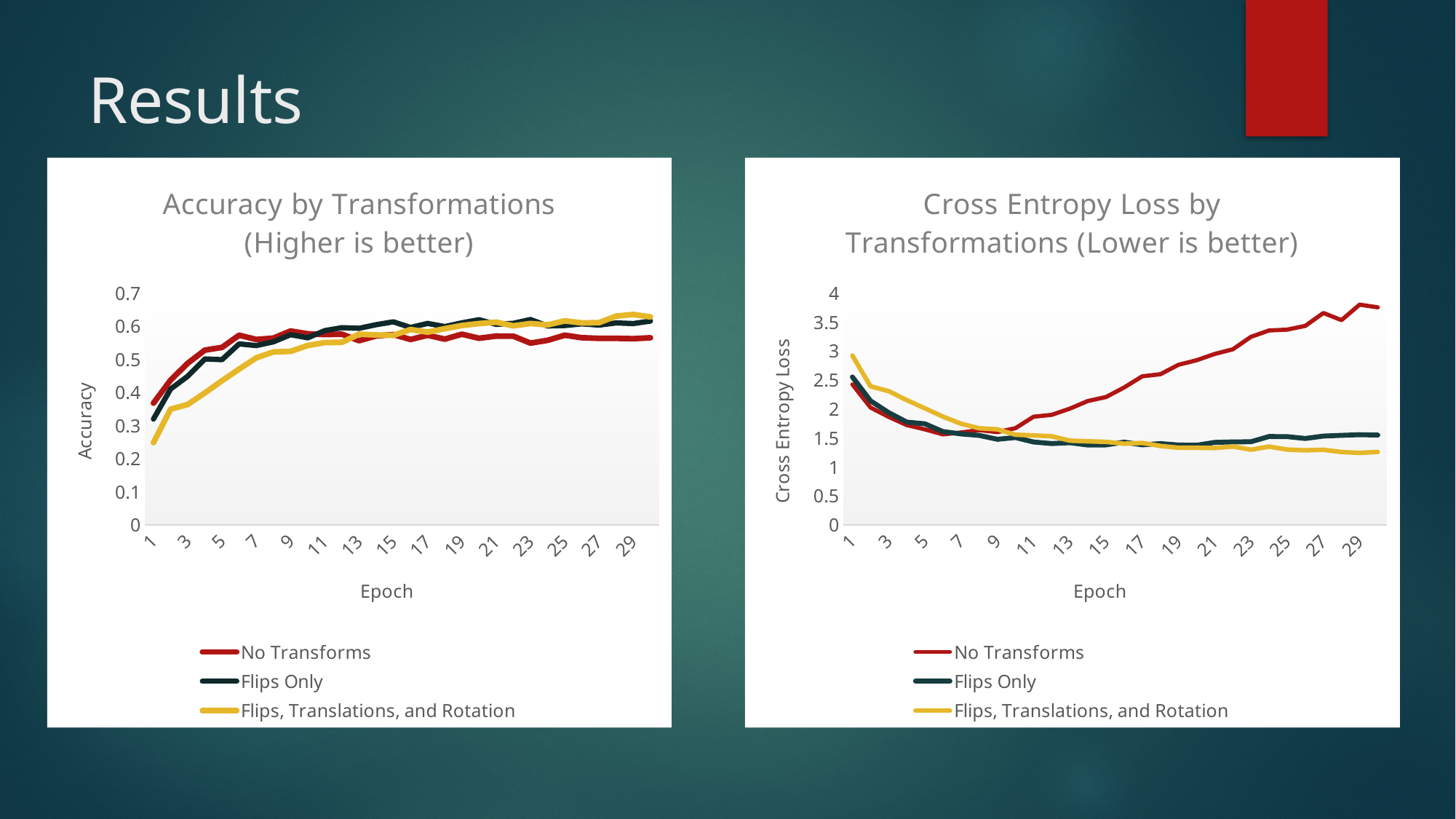
How many series does the legend of the 'Cross Entropy Loss by Transformations (Lower is better)' chart list? 3 In the 'Accuracy by Transformations' chart, is the accuracy for Flips, Translations, and Rotation at epoch 1 greater or less than 0.3? less In the 'Cross Entropy Loss by Transformations' chart, does the loss for Flips, Translations, and Rotation rise or fall from epoch 1 to epoch 29? fall In the 'Accuracy by Transformations' chart, is the accuracy for No Transforms at epoch 1 greater or less than 0.3? greater In the 'Cross Entropy Loss by Transformations' chart, which series has the higher loss at epoch 29: No Transforms or Flips Only? No Transforms In the 'Cross Entropy Loss by Transformations' chart, is the loss for No Transforms at epoch 29 greater or less than 3.5? greater In the 'Cross Entropy Loss by Transformations' chart, does the loss for No Transforms rise or fall from epoch 11 to epoch 29? rise What kind of chart is the 'Accuracy by Transformations (Higher is better)' chart? line chart What is the label of the x axis on the 'Accuracy by Transformations' chart? Epoch In the 'Accuracy by Transformations' chart, which series has the higher accuracy at epoch 1: No Transforms or Flips, Translations, and Rotation? No Transforms